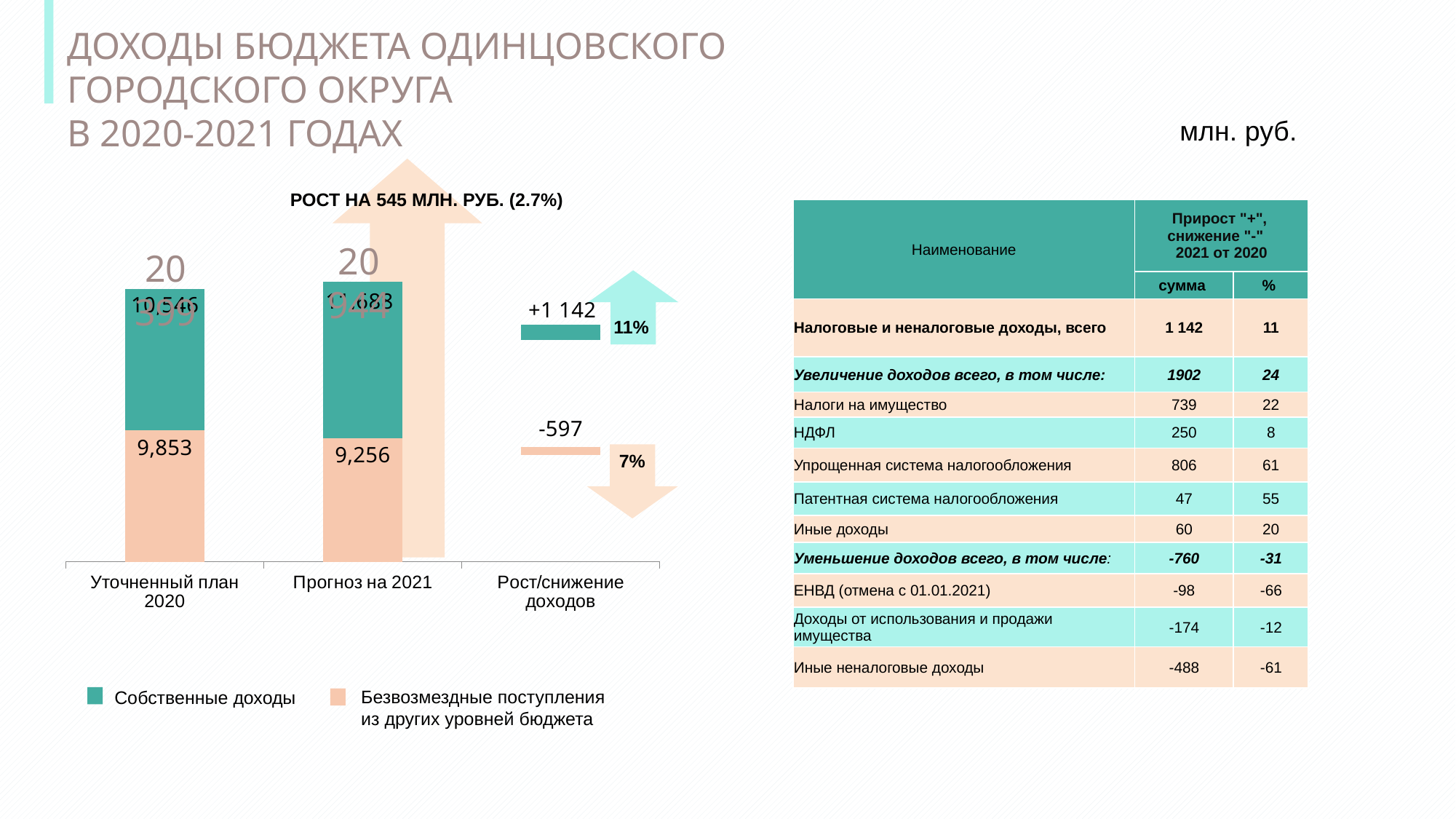
How many categories are shown along the x axis of the bar chart? 3 How many series does the legend of the bar chart list? 2 In the bar chart, what is the value of Безвозмездные поступления из других уровней бюджета for Уточненный план 2020? 9,853 What kind of chart is shown on the left of the slide? bar chart In the bar chart, what change is shown for Собственные доходы in the Рост/снижение доходов category? +1 142 What growth is stated in the text above the bar chart? РОСТ НА 545 МЛН. РУБ. (2.7%) In the bar chart, is the value of Безвозмездные поступления larger for Уточненный план 2020 or for Прогноз на 2021? Уточненный план 2020 In the bar chart, what is the value of Безвозмездные поступления из других уровней бюджета for Прогноз на 2021? 9,256 In the bar chart, what change is shown for Безвозмездные поступления in the Рост/снижение доходов category? -597 What total is printed above the Прогноз на 2021 bar in the bar chart? 20 944 In the bar chart, is the Собственные доходы segment larger for Уточненный план 2020 or for Прогноз на 2021? Прогноз на 2021 In the bar chart, by how much does Безвозмездные поступления for Уточненный план 2020 exceed the value for Прогноз на 2021? 597